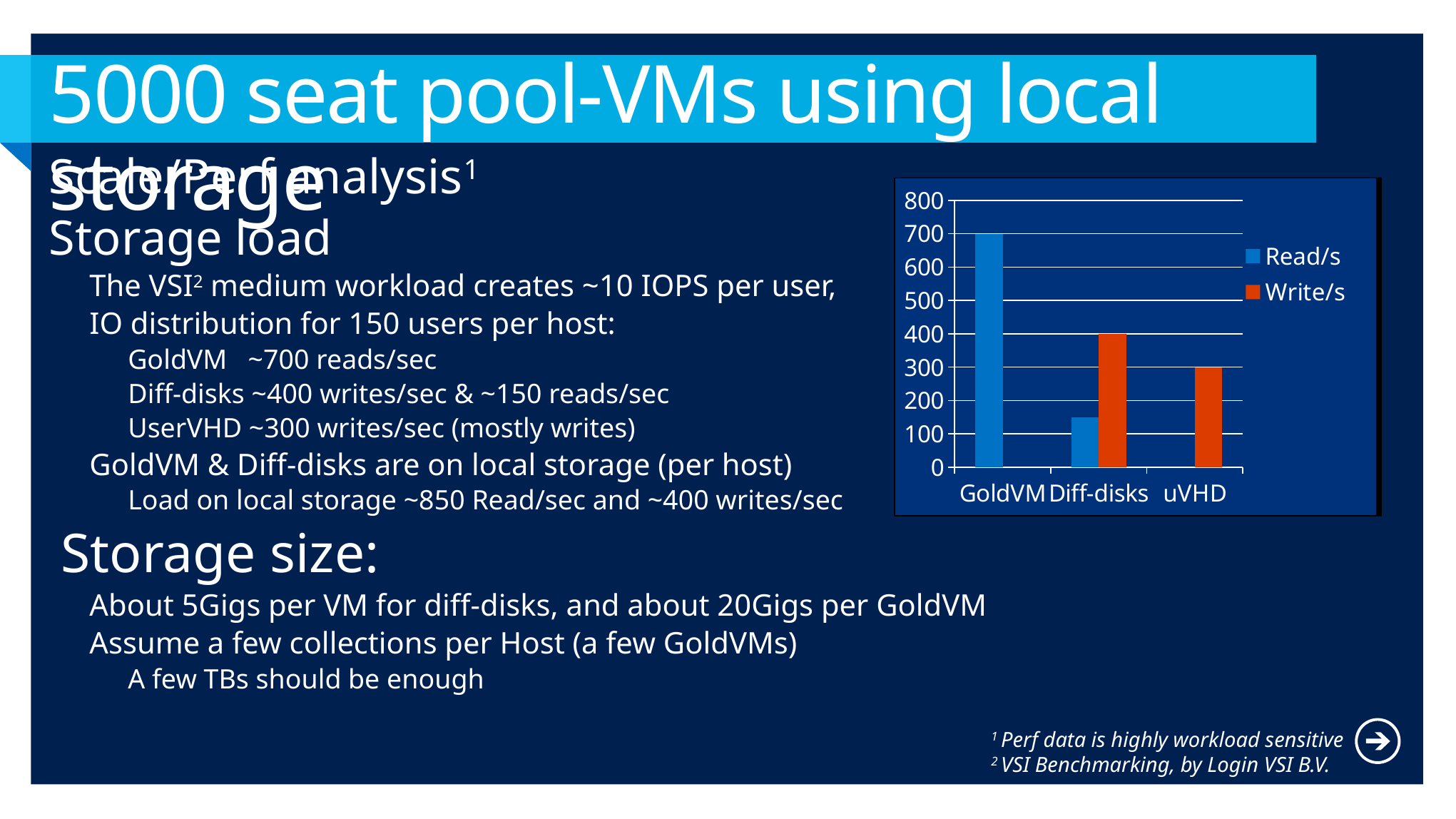
What is the Write/s value for Diff-disks in the chart? 400 Which colour represents the Write/s series in the chart's legend? orange Which category has the highest Read/s bar in the chart? GoldVM Is the Read/s value for Diff-disks greater or less than 200? less How many categories are shown on the x axis of the chart? 3 What is the Read/s value for GoldVM in the chart? 700 How many series does the chart's legend list? 2 Which bar is the lowest in the chart? Diff-disks Read/s What is the difference between the Write/s values for Diff-disks and uVHD? 100 What is the Write/s value for uVHD in the chart? 300 Which category has the highest Write/s bar in the chart? Diff-disks What kind of chart is shown on the slide? bar chart